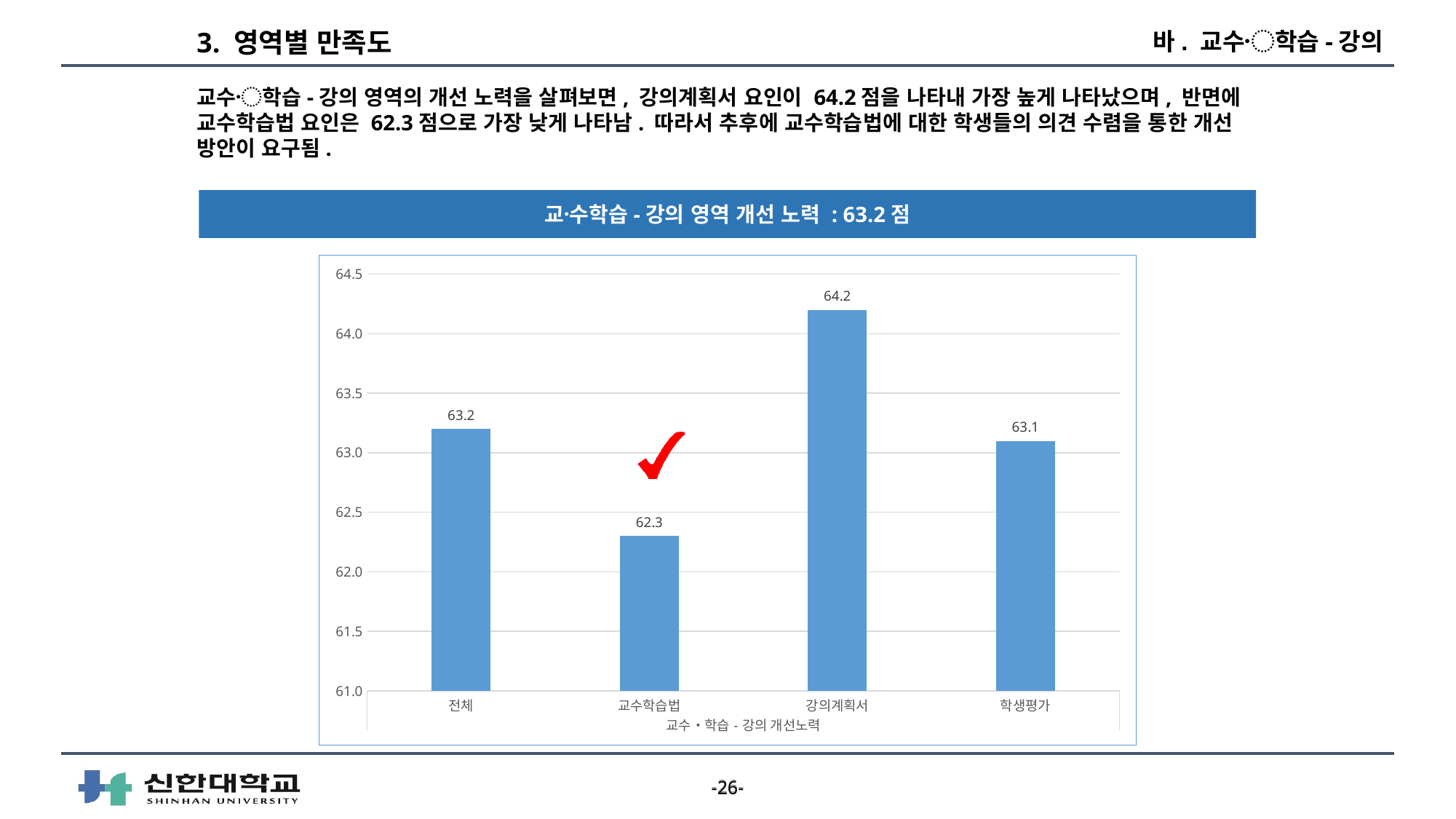
How many categories are shown on the x axis? 4 What is the difference between the values for 강의계획서 and 교수학습법? 1.9 What is the value for 교수학습법? 62.3 What is the value for 전체? 63.2 What is the value for 강의계획서? 64.2 Is the value for 강의계획서 greater or less than 64.0? greater Which is larger, the value for 전체 or the value for 학생평가? 전체 What kind of chart is shown? bar chart Which category has the lowest value? 교수학습법 What is the x-axis title of the chart? 교수・학습 - 강의 개선노력 Which category has the highest value? 강의계획서 What is the value for 학생평가? 63.1